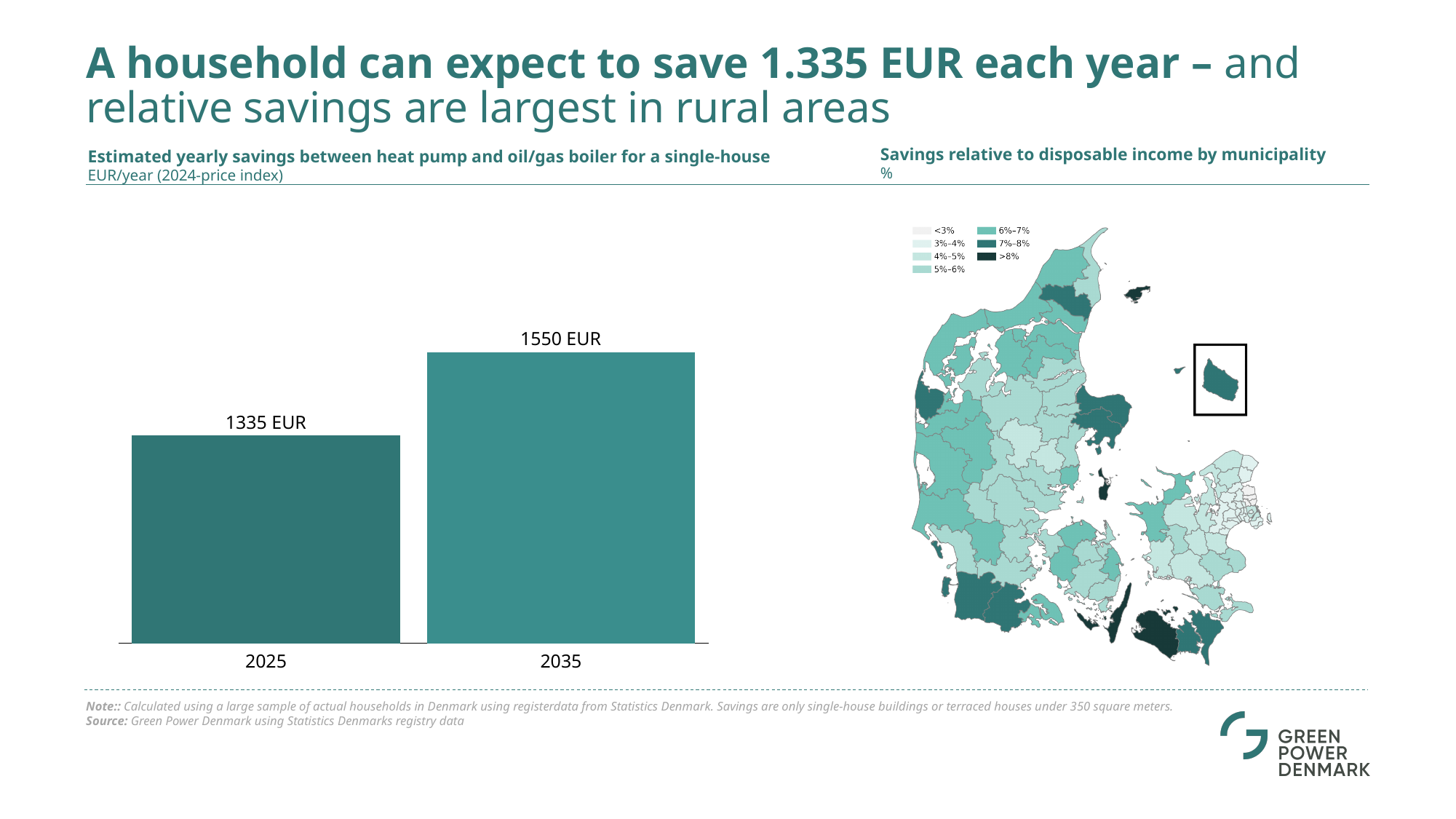
In the 'Estimated yearly savings between heat pump and oil/gas boiler for a single-house' chart, which year has the higher savings? 2035 In the 'Estimated yearly savings between heat pump and oil/gas boiler for a single-house' chart, what is the value for 2035? 1550 EUR What unit is given under the title of the 'Estimated yearly savings between heat pump and oil/gas boiler for a single-house' chart? EUR/year (2024-price index) In the 'Estimated yearly savings between heat pump and oil/gas boiler for a single-house' chart, what is the value for 2025? 1335 EUR In the 'Estimated yearly savings between heat pump and oil/gas boiler for a single-house' chart, is the value for 2025 larger or smaller than the value for 2035? smaller In the 'Estimated yearly savings between heat pump and oil/gas boiler for a single-house' chart, which year has the lower savings? 2025 In the 'Savings relative to disposable income by municipality' map, what is the highest category shown in the legend? >8% What kind of chart is the 'Estimated yearly savings between heat pump and oil/gas boiler for a single-house' chart? bar chart In the 'Savings relative to disposable income by municipality' map, how many categories does the legend list? 7 In the 'Estimated yearly savings between heat pump and oil/gas boiler for a single-house' chart, do the values rise or fall from 2025 to 2035? rise In the 'Estimated yearly savings between heat pump and oil/gas boiler for a single-house' chart, how many bars are shown? 2 In the 'Estimated yearly savings between heat pump and oil/gas boiler for a single-house' chart, what is the difference between the 2035 and 2025 values? 215 EUR